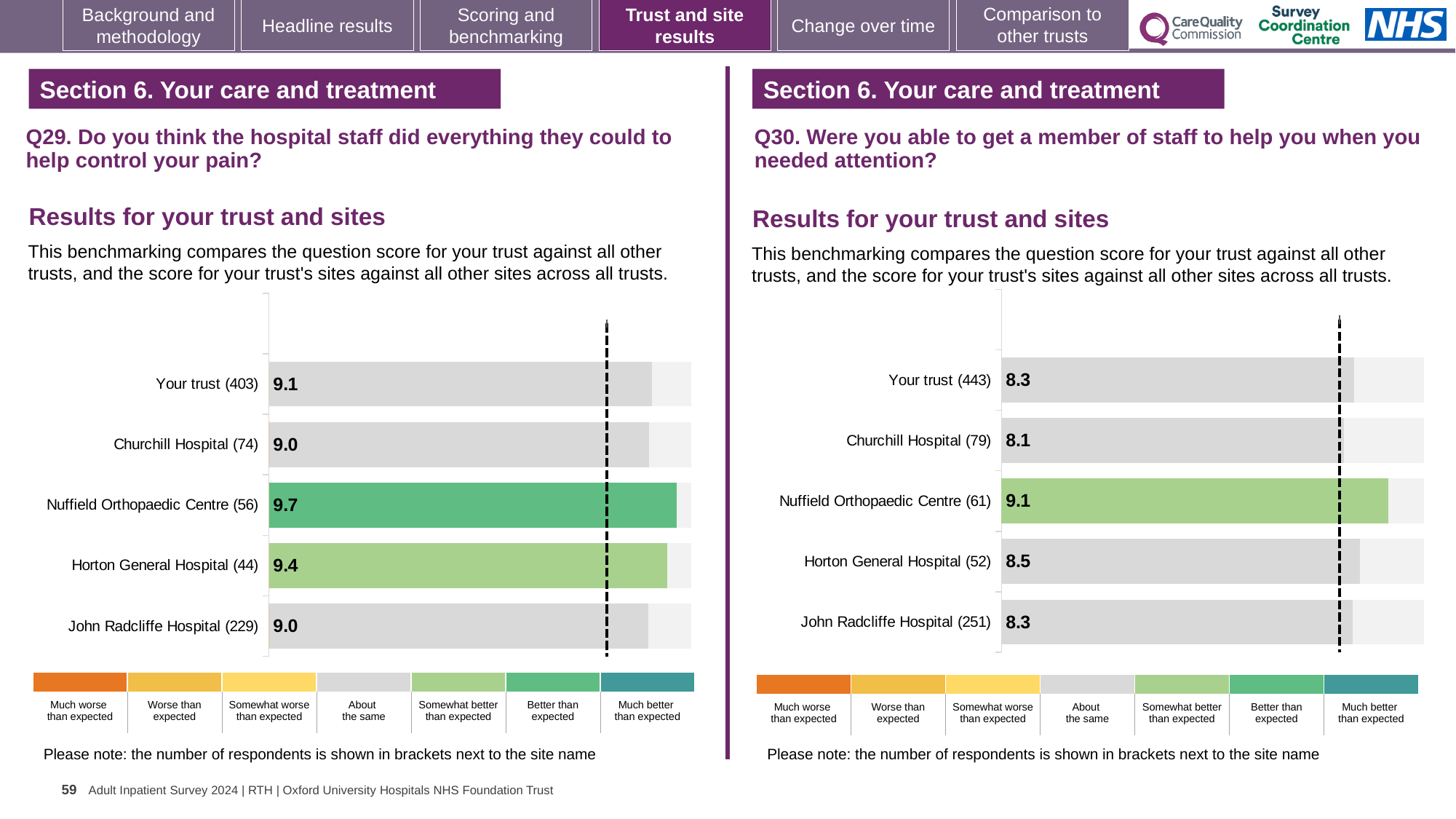
In the Q29 chart on the left, what is the difference between the scores for Nuffield Orthopaedic Centre and Horton General Hospital? 0.3 In the Q30 chart on the right, what is the difference between the scores for Nuffield Orthopaedic Centre and Your trust? 0.8 In the Q29 chart on the left, what is the score for Your trust? 9.1 In the Q30 chart on the right, what is the score for Horton General Hospital? 8.5 In the Q29 chart on the left, what is the score for Nuffield Orthopaedic Centre? 9.7 In the Q30 chart on the right, which is larger: the score for Horton General Hospital or the score for Churchill Hospital? Horton General Hospital What kind of chart is used for the Q29 results on the left? Bar chart In the Q30 chart on the right, which site has the highest score? Nuffield Orthopaedic Centre In the Q30 chart on the right, what is the score for John Radcliffe Hospital? 8.3 In the Q30 chart on the right, which site has the lowest score? Churchill Hospital In the Q29 chart on the left, how many bars are plotted? 5 In the Q29 chart on the left, which site has the highest score? Nuffield Orthopaedic Centre